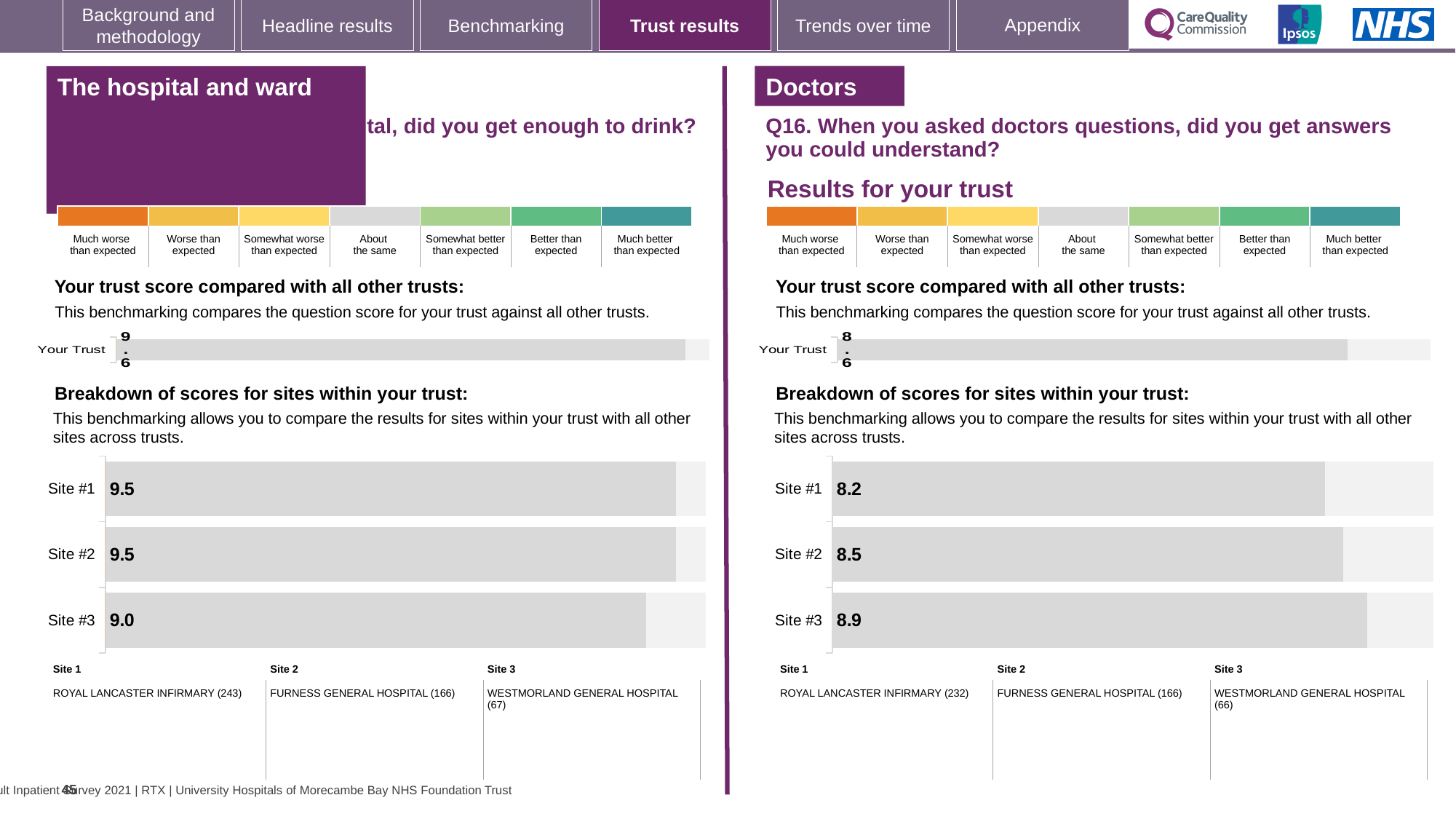
In the left-hand site breakdown chart (did you get enough to drink?), what is the score for Site #1? 9.5 In the left-hand site breakdown chart (did you get enough to drink?), what is the score for Site #3? 9.0 In the Doctors Q16 'Your trust score' chart, what is the value for Your Trust? 8.6 In the left-hand 'Your trust score' chart (did you get enough to drink?), what is the value for Your Trust? 9.6 In the Doctors Q16 site breakdown chart, which site has the highest score? Site #3 In the Doctors Q16 site breakdown chart, which site has the lowest score? Site #1 What kind of chart is the Doctors Q16 site breakdown chart? Bar chart How many sites are shown in the Doctors Q16 site breakdown chart? 3 In the left-hand site breakdown chart (did you get enough to drink?), what is the difference between the scores for Site #1 and Site #3? 0.5 In the Doctors Q16 site breakdown chart, what is the difference between the scores for Site #3 and Site #1? 0.7 In the Doctors Q16 site breakdown chart, what is the score for Site #2? 8.5 In the left-hand site breakdown chart (did you get enough to drink?), which site has the lowest score? Site #3